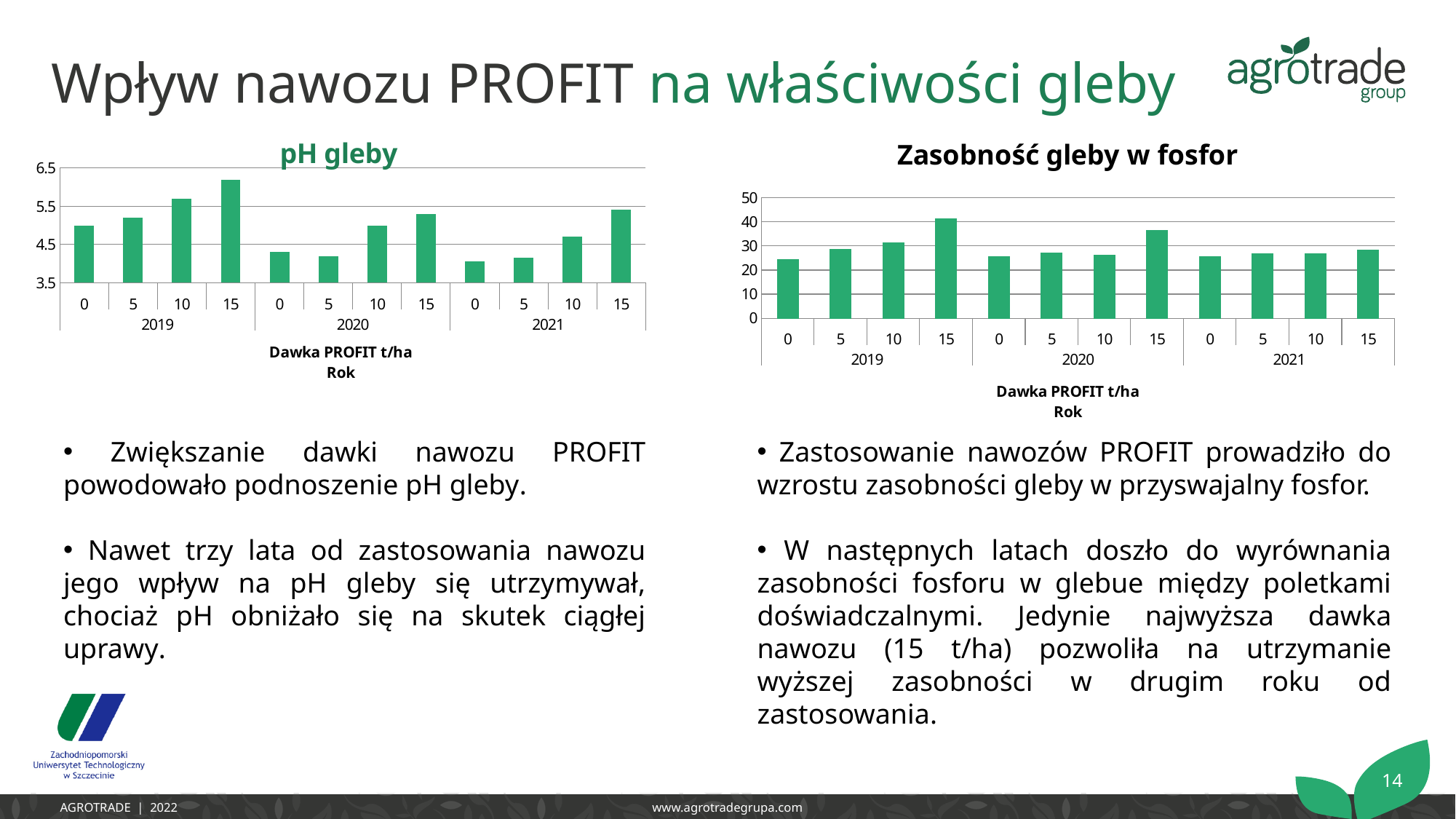
What kind of chart is the 'pH gleby' chart? bar chart In the 'Zasobność gleby w fosfor' chart, how many years are shown on the x axis? 3 In the 'Zasobność gleby w fosfor' chart, which dose and year has the highest bar? 15 in 2019 In the 'pH gleby' chart, how many bars are plotted? 12 In the 'pH gleby' chart, which is larger: the value for dose 10 in 2019 or dose 10 in 2021? dose 10 in 2019 In the 'pH gleby' chart, is the value for dose 15 in 2019 greater or less than 5.5? greater In the 'pH gleby' chart, is the value for dose 0 in 2020 greater or less than 4.5? less What kind of chart is the 'Zasobność gleby w fosfor' chart? bar chart In the 'Zasobność gleby w fosfor' chart, is the value for dose 15 in 2019 greater or less than 40? greater In the 'Zasobność gleby w fosfor' chart, do the values rise or fall as the dose increases from 0 to 15 within 2019? rise In the 'pH gleby' chart, which dose and year has the highest bar? 15 in 2019